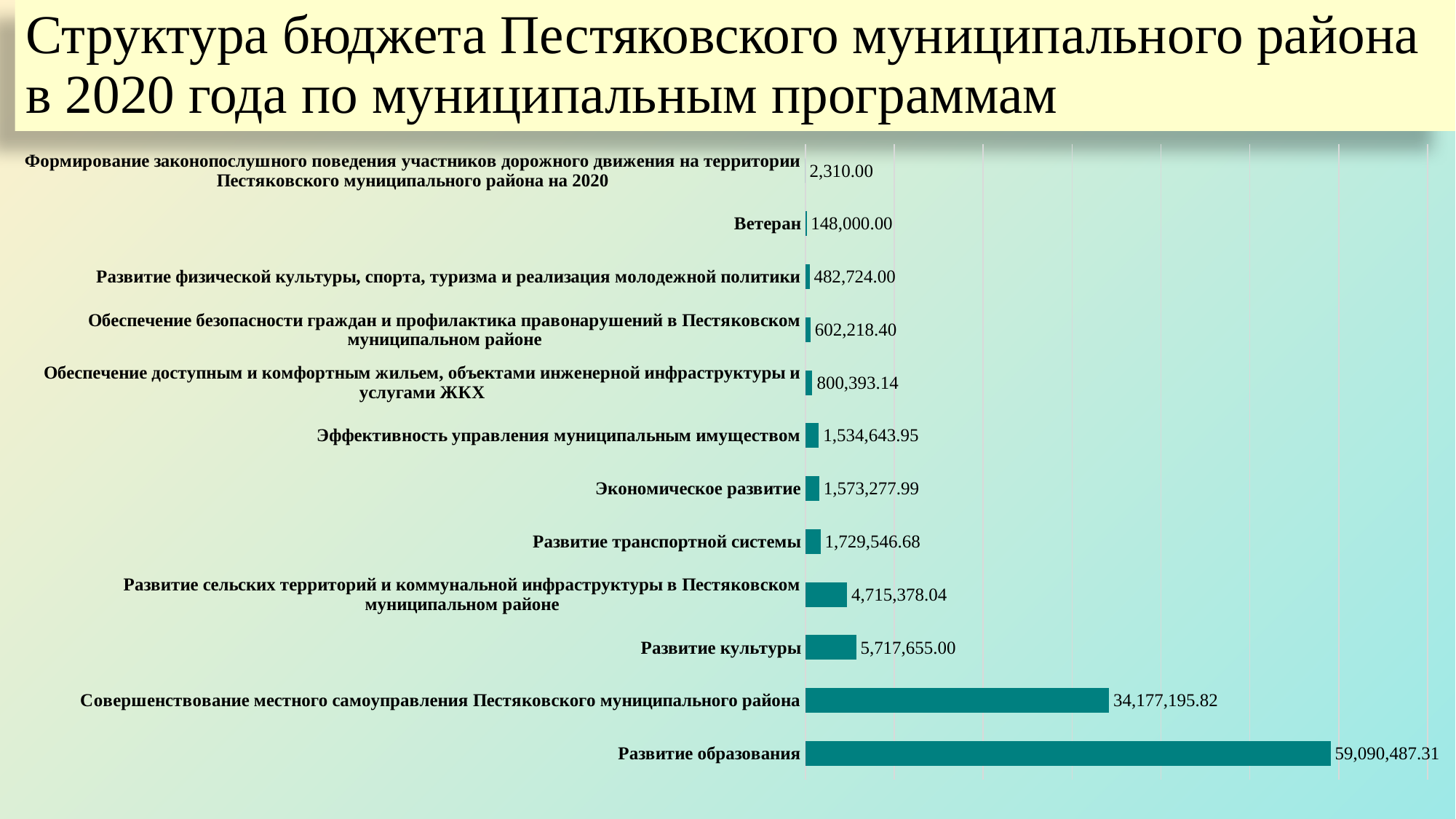
What is the value for Совершенствование местного самоуправления Пестяковского муниципального района? 34,177,195.82 What is the value for Ветеран? 148,000.00 Which is larger: the value for Развитие культуры or the value for Развитие транспортной системы? Развитие культуры What is the title of the slide containing the chart? Структура бюджета Пестяковского муниципального района в 2020 года по муниципальным программам How many programmes (categories) are plotted in the chart? 12 Which programme has the lowest value? Формирование законопослушного поведения участников дорожного движения на территории Пестяковского муниципального района на 2020 What is the value for Экономическое развитие? 1,573,277.99 Which programme has the highest value? Развитие образования What is the difference between the values for Развитие образования and Совершенствование местного самоуправления Пестяковского муниципального района? 24,913,291.49 What kind of chart is shown on the slide? bar chart What is the value for Развитие культуры? 5,717,655.00 What is the value for Развитие образования? 59,090,487.31